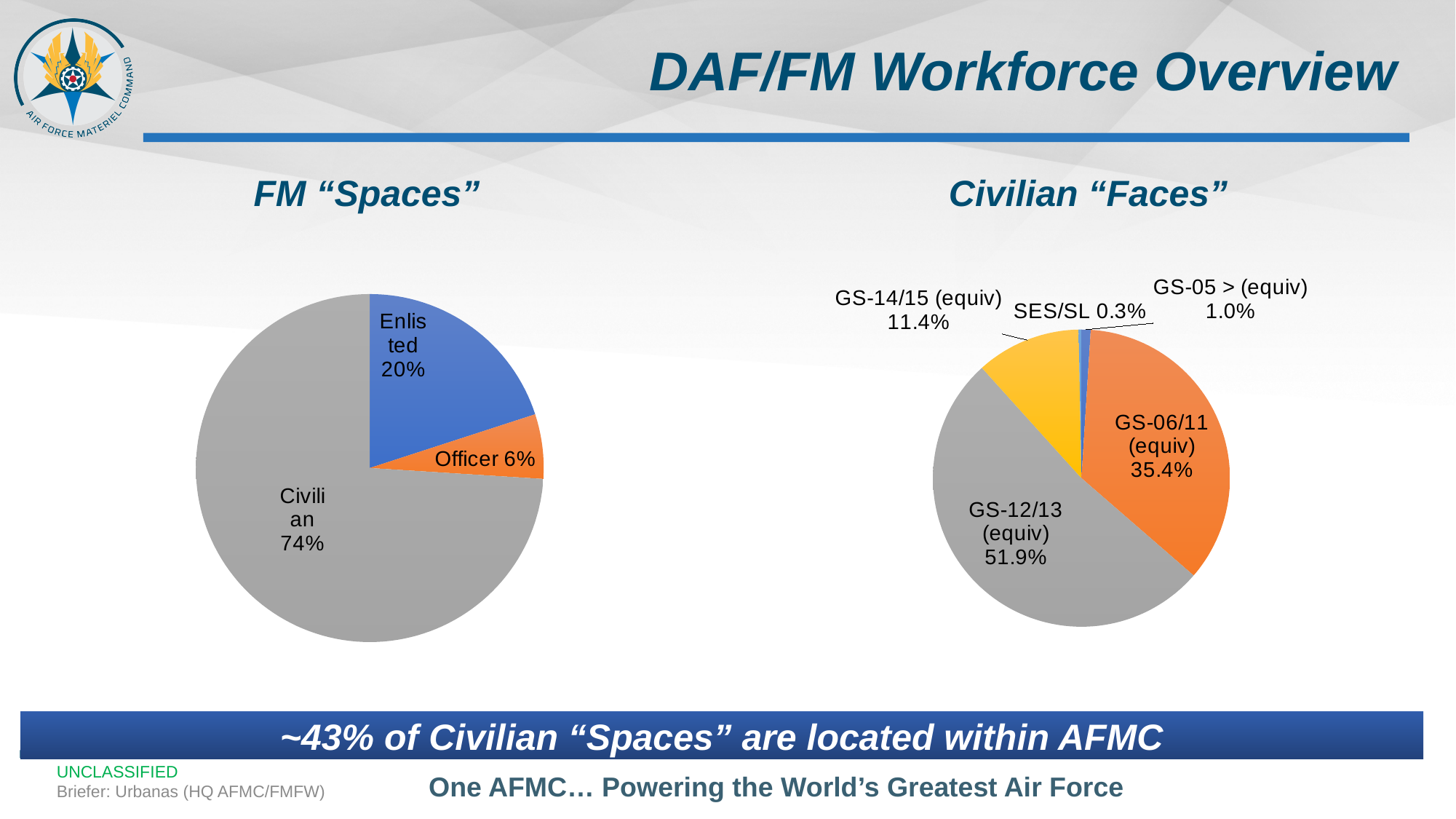
In the FM "Spaces" pie chart, what share is Enlisted? 20% In the FM "Spaces" pie chart, what share is Officer? 6% In the Civilian "Faces" pie chart, what share is GS-12/13 (equiv)? 51.9% In the Civilian "Faces" pie chart, what share is GS-06/11 (equiv)? 35.4% In the Civilian "Faces" pie chart, which is larger: GS-14/15 (equiv) or GS-05 > (equiv)? GS-14/15 (equiv) What type of chart is used for Civilian "Faces"? Pie chart In the FM "Spaces" pie chart, what share is Civilian? 74% In the FM "Spaces" pie chart, which category has the smallest share? Officer In the Civilian "Faces" pie chart, which category has the largest share? GS-12/13 (equiv) In the FM "Spaces" pie chart, what is the difference between the Enlisted and Officer shares? 14% In the FM "Spaces" pie chart, how many slices are there? 3 In the Civilian "Faces" pie chart, what share is SES/SL? 0.3%